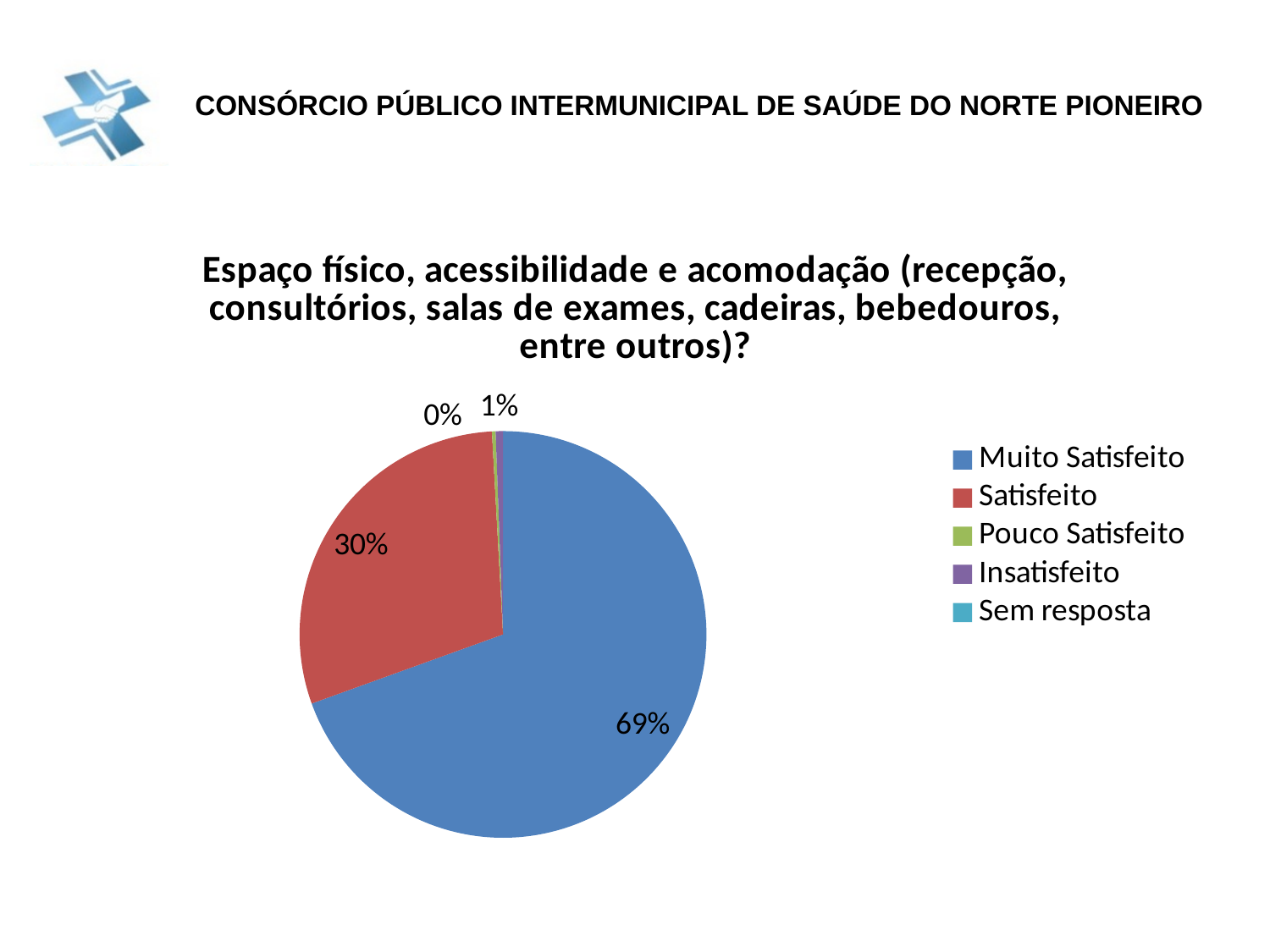
What percentage of respondents answered "Muito Satisfeito"? 69% How many categories does the legend list? 5 What is the last entry listed in the chart legend? Sem resposta What percentage of respondents answered "Satisfeito"? 30% Which response category has the largest share of the pie? Muito Satisfeito Which is larger, the share for "Insatisfeito" or the share for "Pouco Satisfeito"? Insatisfeito Which is larger, the share for "Satisfeito" or the share for "Muito Satisfeito"? Muito Satisfeito What percentage is shown for "Insatisfeito"? 1% What is the difference in percentage points between "Muito Satisfeito" and "Satisfeito"? 39 percentage points What colour represents "Satisfeito" in the pie chart? Red What percentage is shown for "Pouco Satisfeito"? 0% What type of chart is shown on the slide? Pie chart